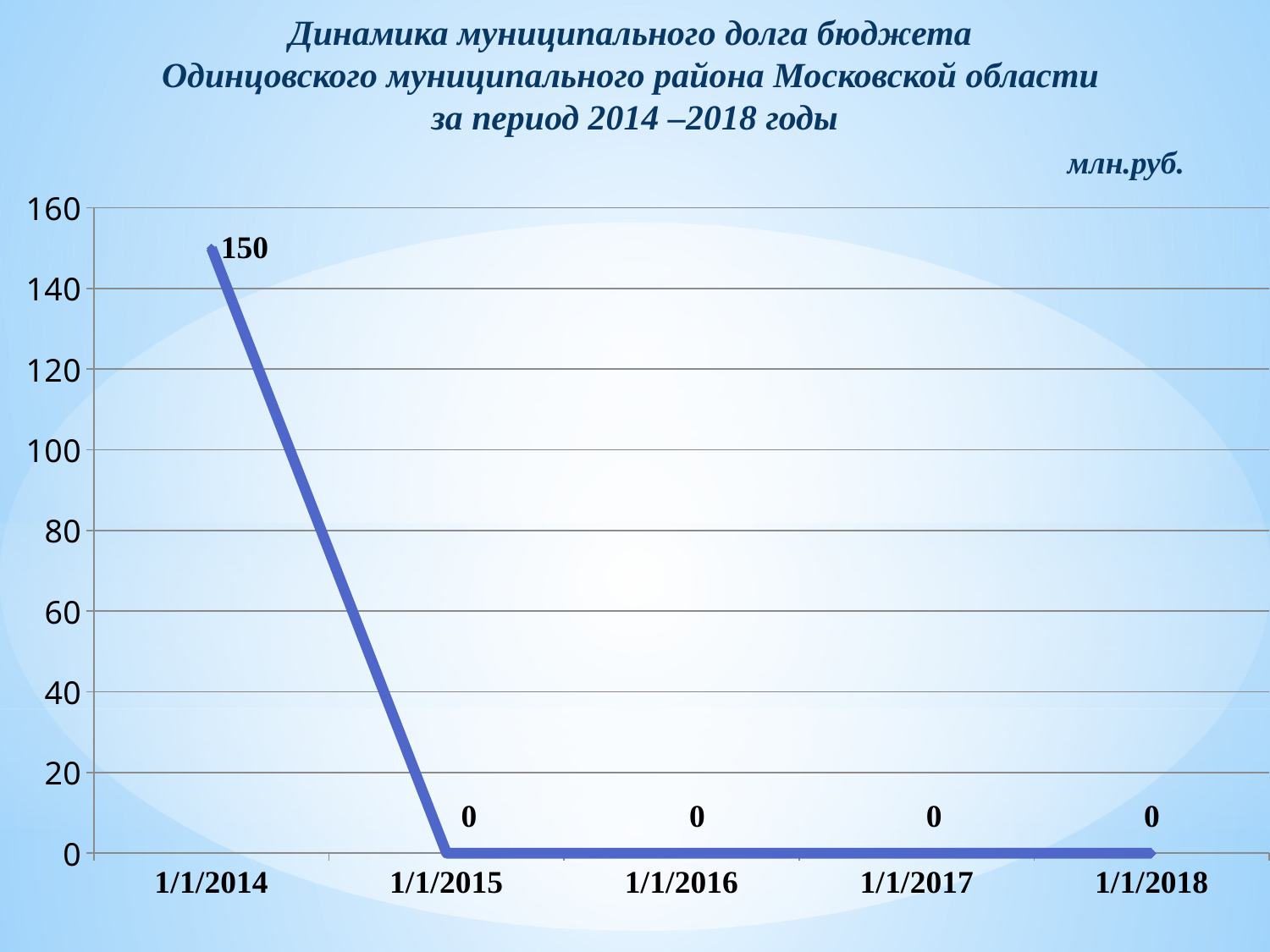
What unit of measurement is indicated above the chart? млн.руб. How many data points are plotted on the chart? 5 Is the value for 1/1/2014 greater or less than 140? greater Which is larger, the value for 1/1/2014 or the value for 1/1/2016? 1/1/2014 What kind of chart is shown on the slide? line chart What is the value for 1/1/2015? 0 What is the value for 1/1/2018? 0 What is the difference between the values for 1/1/2014 and 1/1/2015? 150 What is the highest value shown on the vertical axis? 160 Do the values rise or fall from 1/1/2014 to 1/1/2015? fall What is the value for 1/1/2014? 150 Which date has the highest value? 1/1/2014